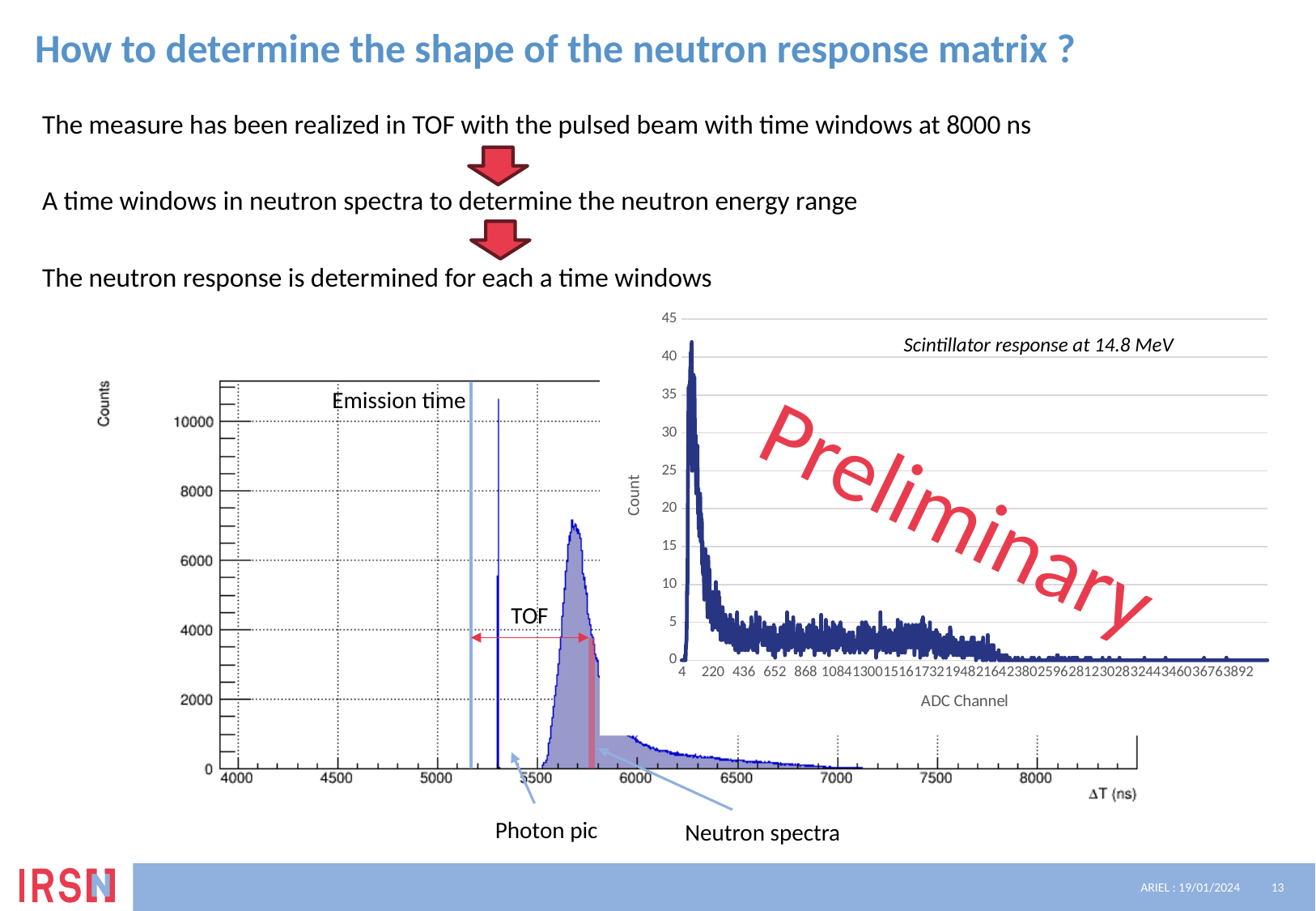
In the chart on the left, which is higher: the photon peak or the neutron spectrum peak? photon peak In the chart on the left, is the height of the photon peak greater or less than 10000 counts? greater In the chart on the left, is the maximum of the neutron spectrum greater or less than 6000 counts? greater How many charts are shown on the slide? 2 In the chart on the right, does the curve rise or fall along the x axis after its initial peak? fall In the chart on the right, is the peak value of the curve greater or less than 40? greater In the chart on the right, what is the highest value shown on the y axis? 45 In the chart on the left, what is the label of the x axis? ΔT (ns) What is the title of the chart on the right of the slide? Scintillator response at 14.8 MeV What kind of chart is the chart on the right titled 'Scintillator response at 14.8 MeV'? line chart In the chart on the right, what is the label of the x axis? ADC Channel